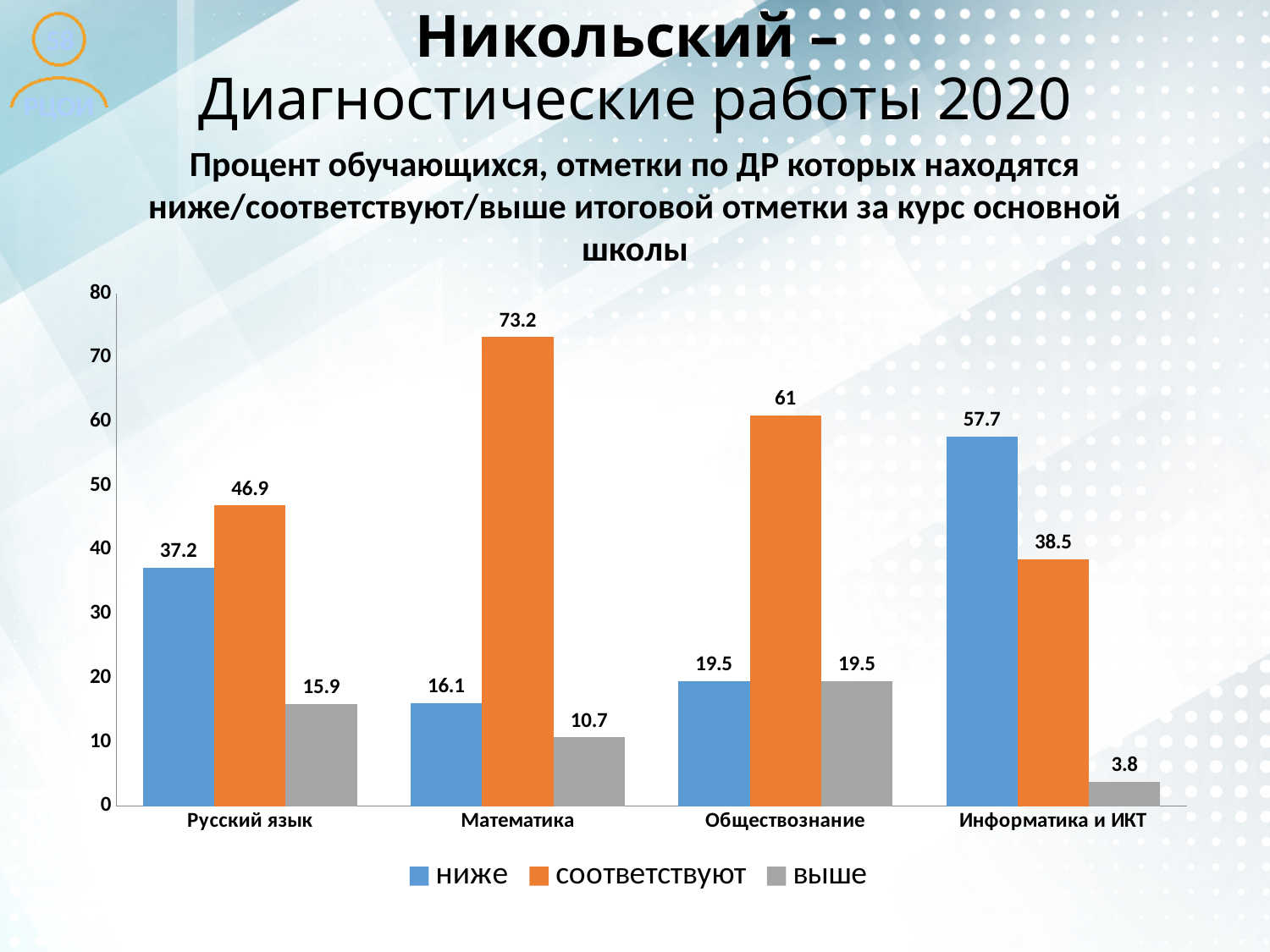
For Обществознание, which is larger: the "ниже" value or the "соответствуют" value? соответствуют Which subject has the highest value in the "соответствуют" series? Математика What is the difference between the "соответствуют" and "ниже" values for Русский язык? 9.7 Is the "ниже" value for Математика greater or less than 20? less How many subjects are shown on the x axis? 4 What is the value of the "соответствуют" series for Математика? 73.2 What is the value of the "ниже" series for Информатика и ИКТ? 57.7 What kind of chart is shown on the slide? bar chart How many series does the legend list? 3 Which colour represents the "выше" series in the legend? grey What is the value of the "выше" series for Русский язык? 15.9 Which subject has the lowest value in the "выше" series? Информатика и ИКТ